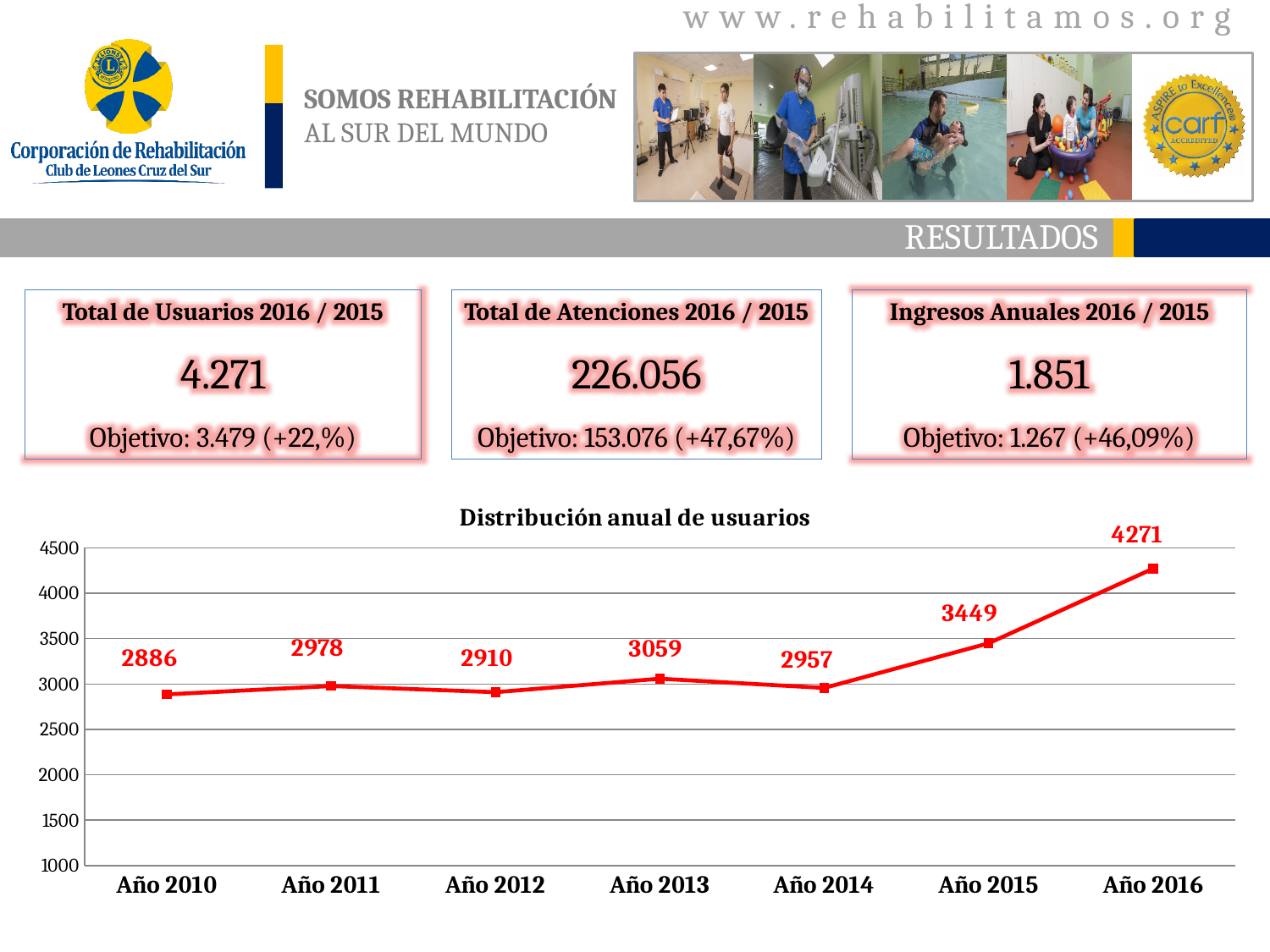
Do the values in the 'Distribución anual de usuarios' chart rise or fall from Año 2014 to Año 2016? rise Which year has the lowest value in the 'Distribución anual de usuarios' chart? Año 2010 Which is larger in the 'Distribución anual de usuarios' chart, the value for Año 2011 or Año 2014? Año 2011 How many years are plotted in the 'Distribución anual de usuarios' chart? 7 What is the difference between the values for Año 2016 and Año 2015 in the 'Distribución anual de usuarios' chart? 822 Which year has the highest value in the 'Distribución anual de usuarios' chart? Año 2016 Is the value for Año 2015 in the 'Distribución anual de usuarios' chart greater or less than 3000? greater What kind of chart is 'Distribución anual de usuarios'? line chart What is the value for Año 2010 in the 'Distribución anual de usuarios' chart? 2886 What is the value for Año 2013 in the 'Distribución anual de usuarios' chart? 3059 What is the value for Año 2016 in the 'Distribución anual de usuarios' chart? 4271 What is the difference between the values for Año 2013 and Año 2012 in the 'Distribución anual de usuarios' chart? 149